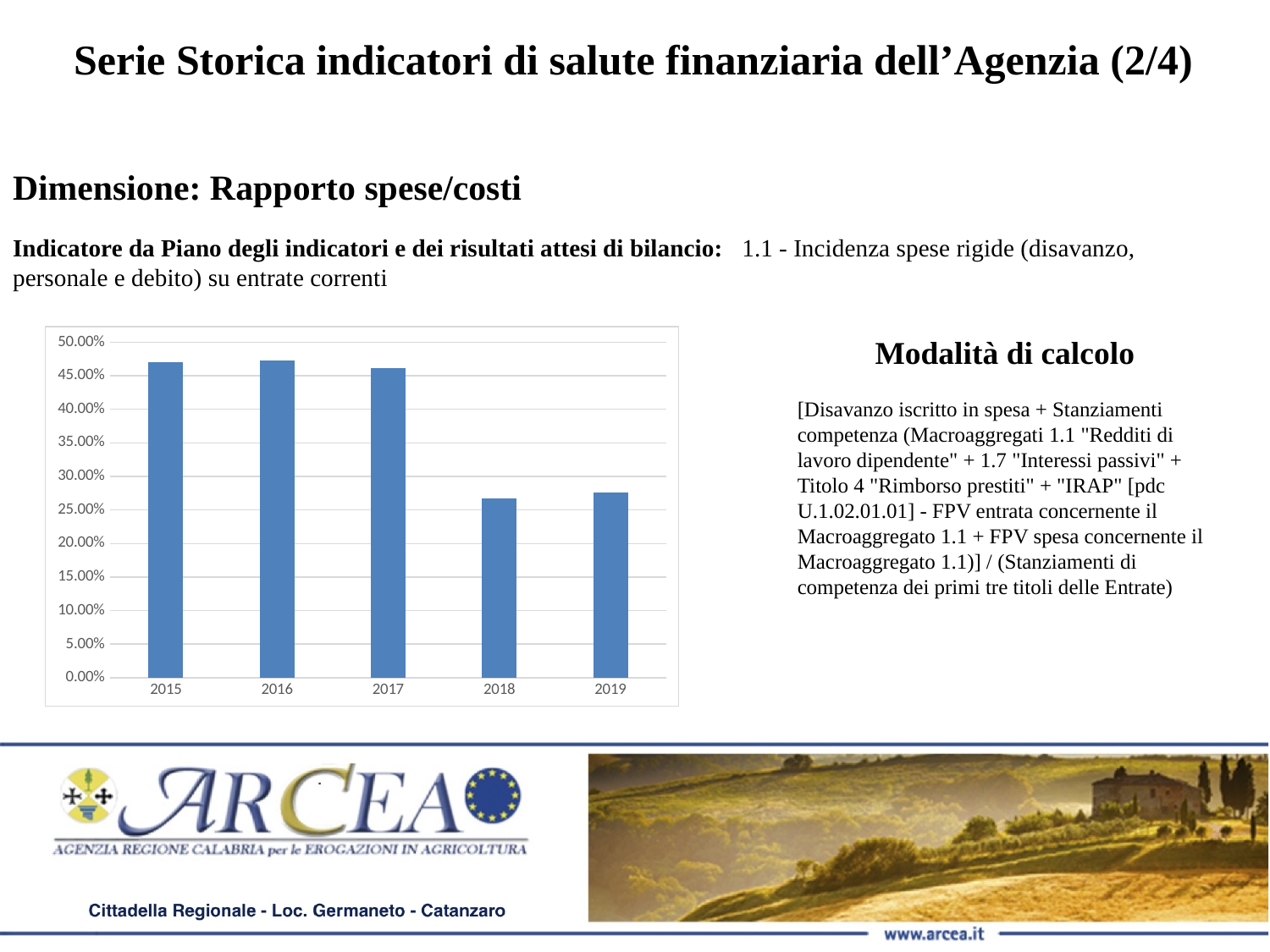
How many years are shown on the x axis of the chart? 5 What kind of chart is shown on the slide? bar chart Which year has the larger value, 2015 or 2019? 2015 Which year has the larger value, 2017 or 2018? 2017 Is the value for 2018 greater or less than 30.00%? less Is the value for 2017 greater or less than 40.00%? greater Is the value for 2015 greater or less than 45.00%? greater What is the first year shown on the x axis of the chart? 2015 What is the highest value shown on the y axis of the chart? 50.00% Do the values overall rise or fall from 2015 to 2019? fall